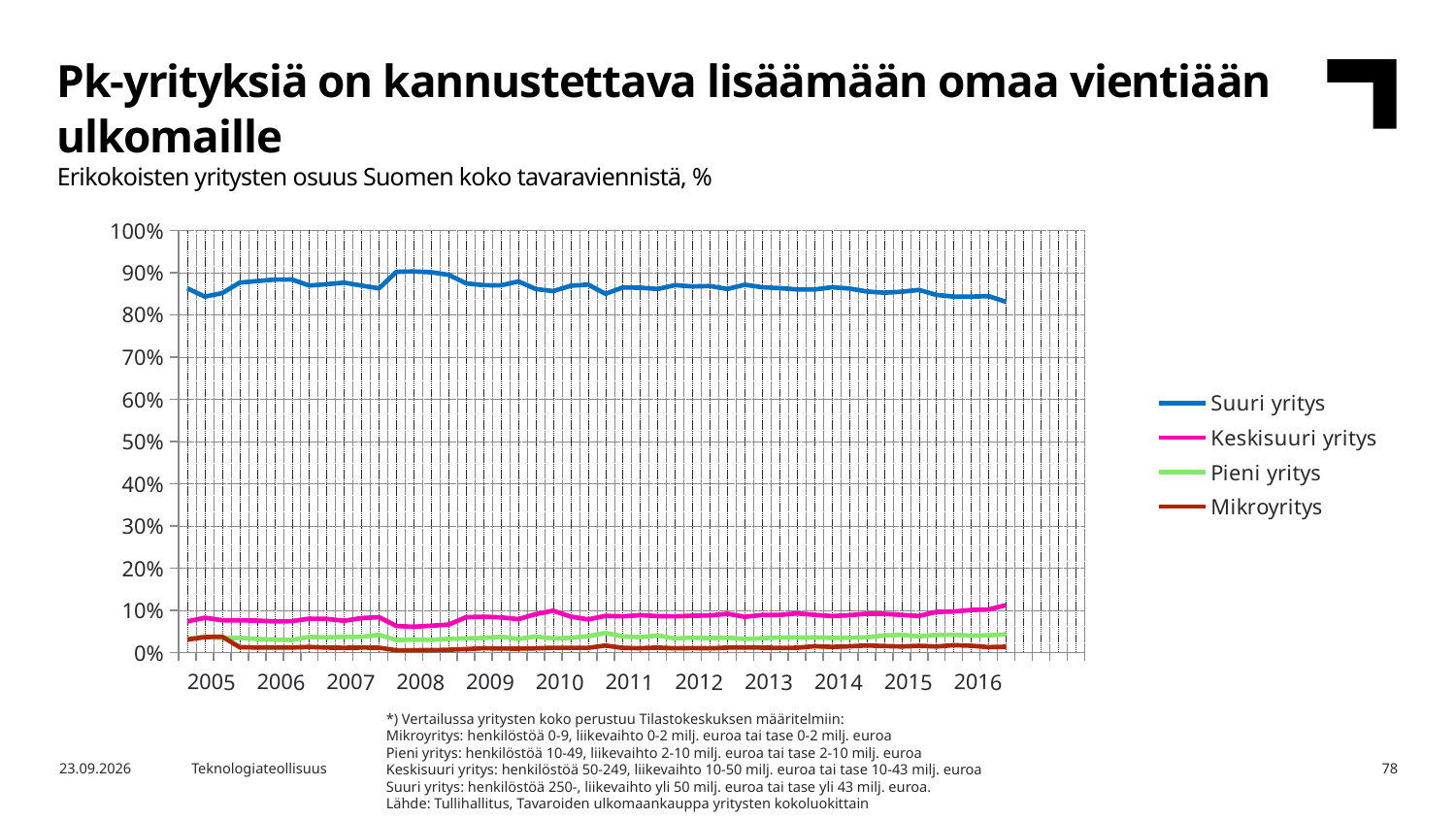
Is the value for Mikroyritys in 2010 greater or less than 10%? less What is the subtitle describing the chart's data? Erikokoisten yritysten osuus Suomen koko tavaraviennistä, % How many series does the legend list? 4 Is the value for Suuri yritys in 2008 greater or less than 80%? greater Is the value for Keskisuuri yritys in 2016 greater or less than 20%? less Which series has the highest values throughout the chart? Suuri yritys How many years are labelled on the x axis? 12 Which series has the lowest values throughout the chart? Mikroyritys Which series is higher in 2014, Keskisuuri yritys or Pieni yritys? Keskisuuri yritys What kind of chart is shown on the slide? Line chart What colour is the line for Suuri yritys? Blue